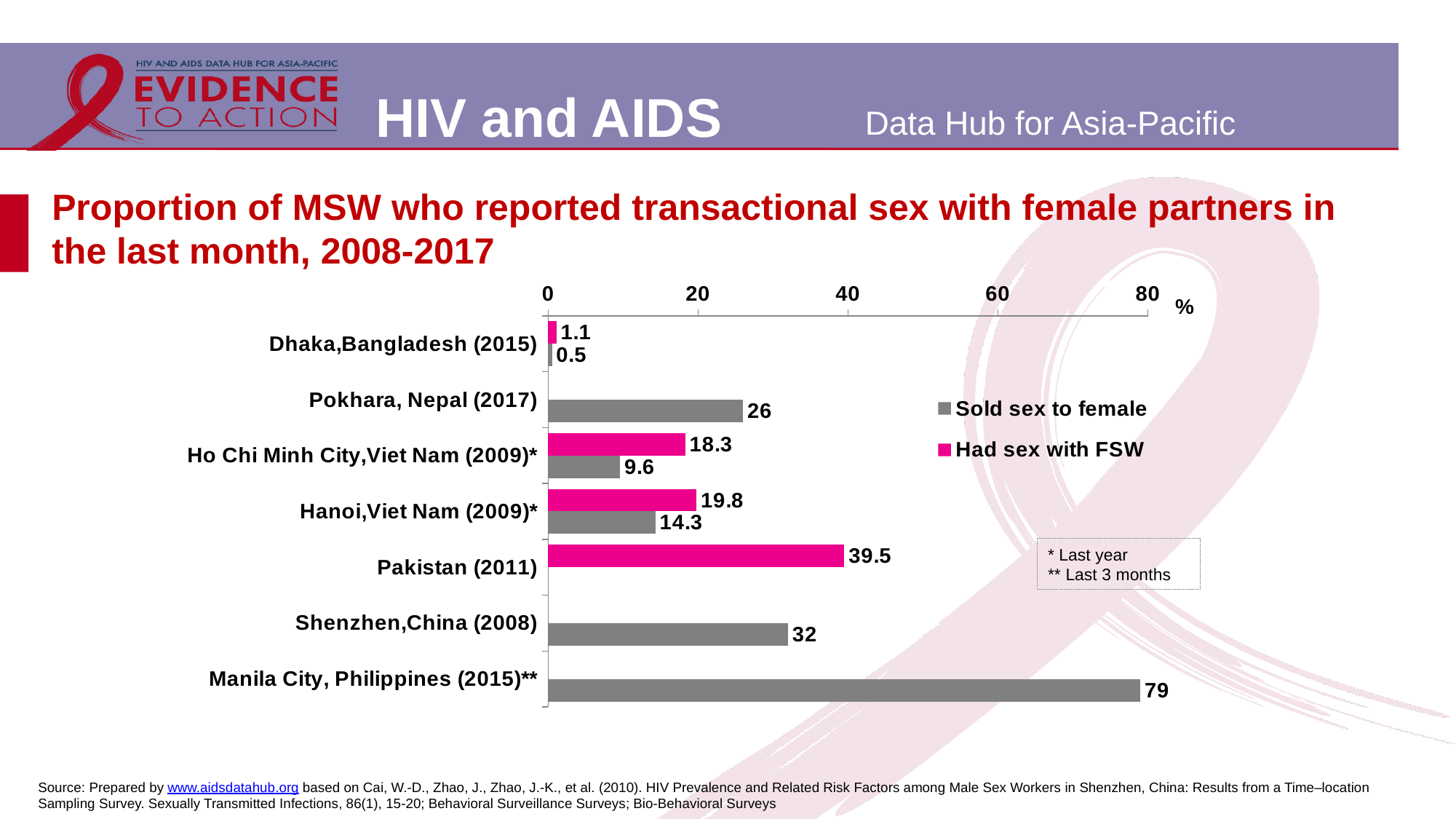
How many series does the legend list? 2 Which is larger: the 'Sold sex to female' value for Shenzhen, China (2008) or for Pokhara, Nepal (2017)? Shenzhen, China (2008) What kind of chart is shown on the slide? Bar chart What is the difference between the 'Had sex with FSW' and 'Sold sex to female' values for Hanoi, Viet Nam (2009)*? 5.5 Which category has the lowest 'Had sex with FSW' value? Dhaka, Bangladesh (2015) What is the value for 'Sold sex to female' in Ho Chi Minh City, Viet Nam (2009)*? 9.6 Which colour represents the 'Had sex with FSW' series in the chart? Pink How many categories are shown on the y axis of the chart? 7 Which category has the highest 'Sold sex to female' value? Manila City, Philippines (2015)** What is the value for 'Had sex with FSW' in Pakistan (2011)? 39.5 What is the value for 'Had sex with FSW' in Hanoi, Viet Nam (2009)*? 19.8 What is the value for 'Sold sex to female' in Manila City, Philippines (2015)**? 79